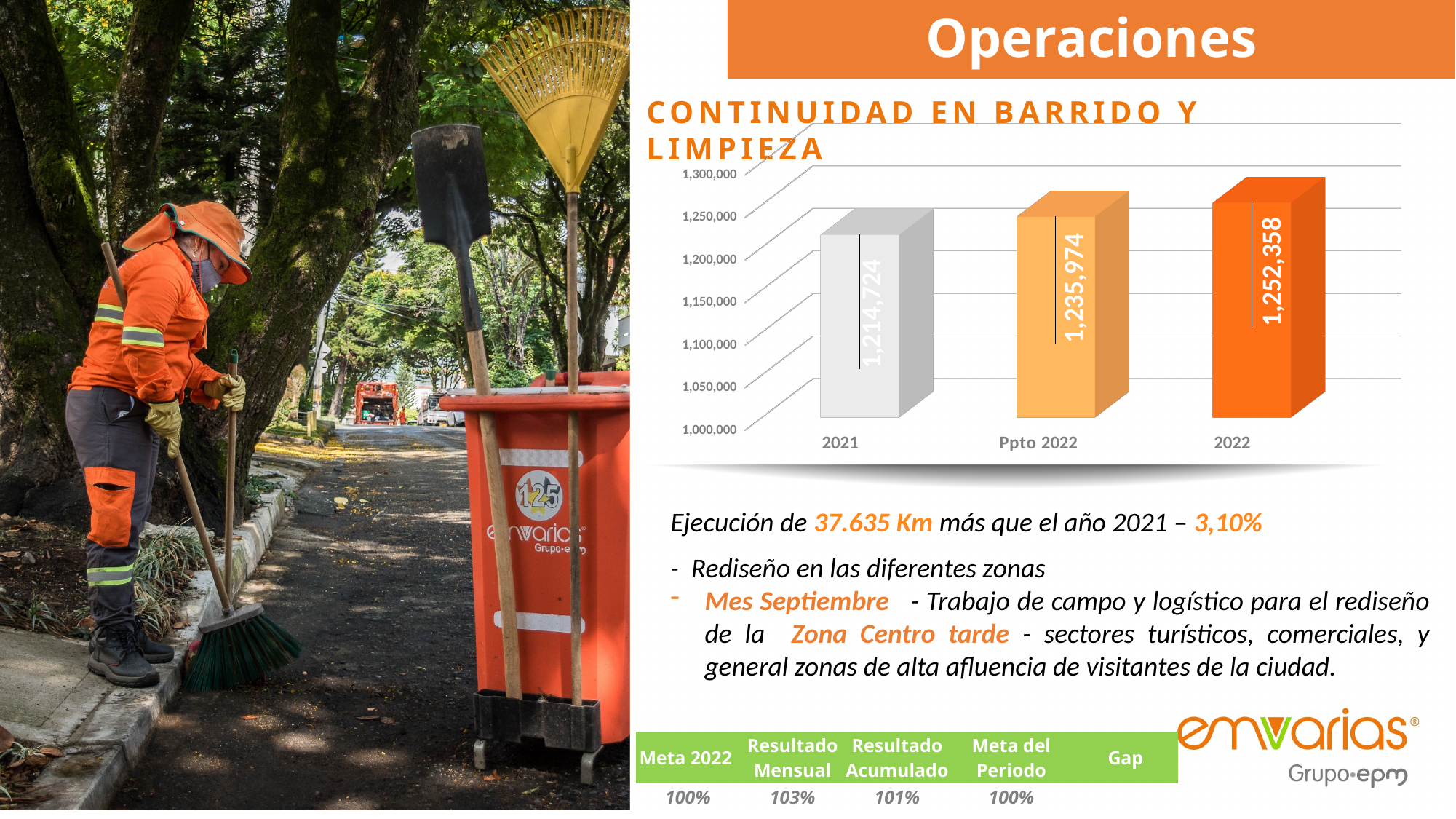
Which category has the highest value in the chart? 2022 Which category has the lowest value in the chart? 2021 What is the value for 2022 in the chart? 1,252,358 What is the difference between the values for 2022 and Ppto 2022? 16,384 What is the difference between the values for 2022 and 2021? 37,634 What is the value for 2021 in the chart? 1,214,724 What is the title of the chart? CONTINUIDAD EN BARRIDO Y LIMPIEZA What kind of chart is shown on the slide? bar chart How many categories are shown in the chart? 3 Is the value for 2021 greater or less than 1,250,000? less Which is larger, the value for Ppto 2022 or the value for 2021? Ppto 2022 What is the value for Ppto 2022 in the chart? 1,235,974